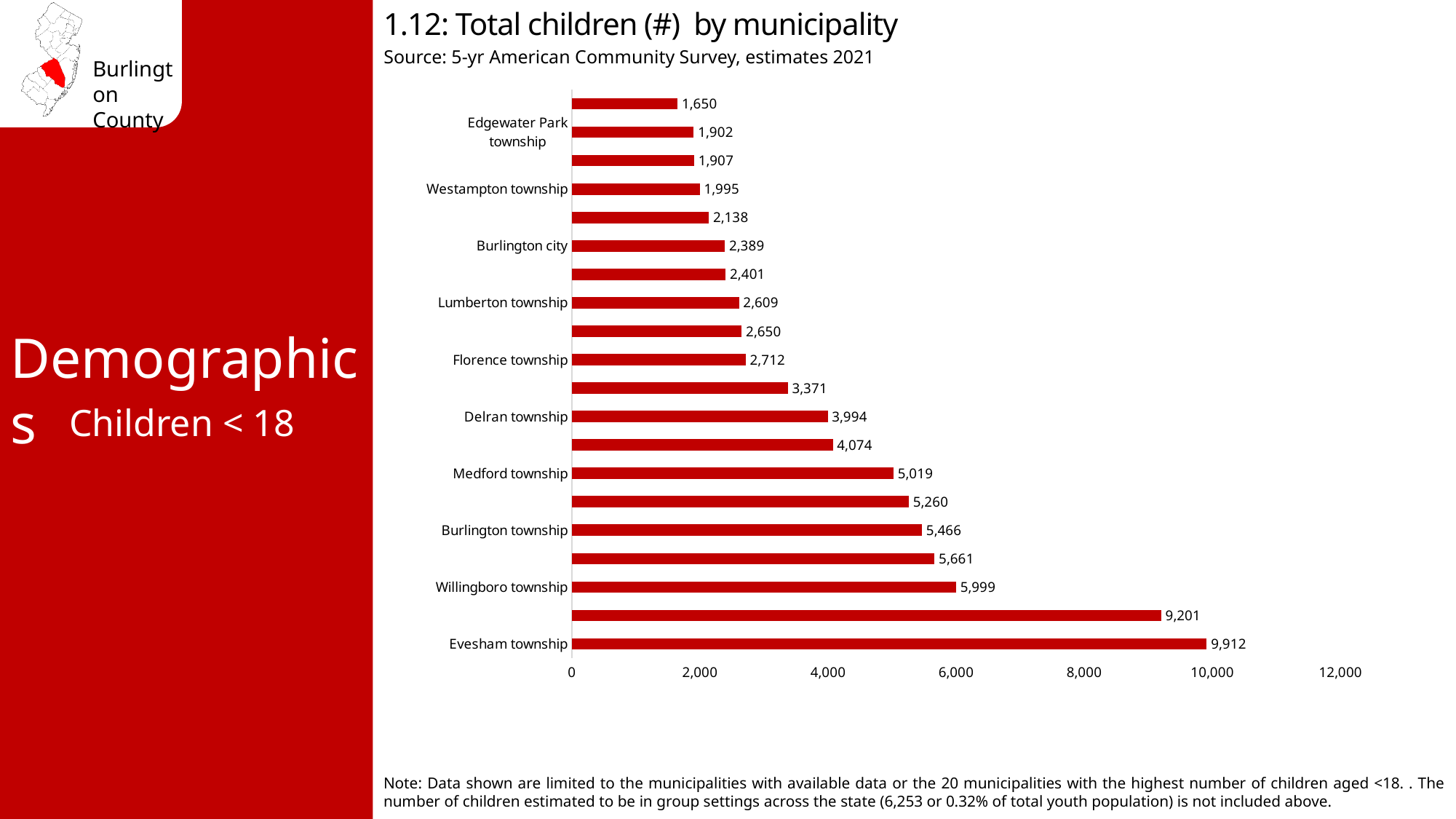
Is the value for Florence township greater or less than 2,000? greater What is the difference between the number of children in Medford township and Delran township? 1,025 What is the smallest value shown on the chart? 1,650 What is the difference between the number of children in Evesham township and Willingboro township? 3,913 What is the total number of children in Delran township? 3,994 Which municipality has the highest number of children? Evesham township Which has more children, Burlington township or Medford township? Burlington township What is the total number of children in Burlington city? 2,389 What type of chart is shown on the slide? Bar chart What is the total number of children in Evesham township? 9,912 How many bars are shown on the chart? 20 What is the total number of children in Willingboro township? 5,999